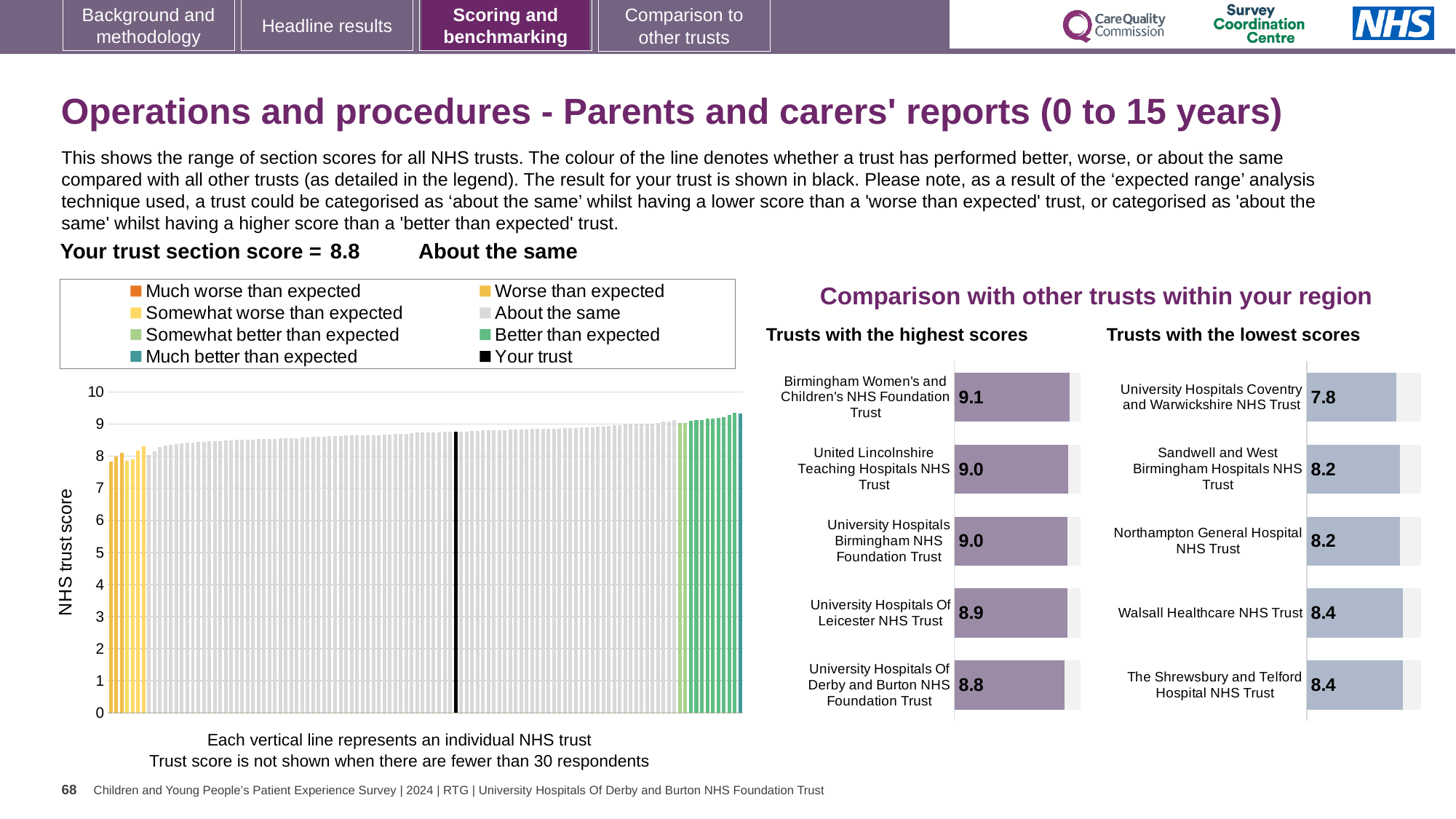
In the large chart on the left, is the value for the rightmost bar greater or less than 9? greater In the 'Trusts with the highest scores' chart, how many trusts are shown? 5 In the large chart on the left, what is the label on the vertical axis? NHS trust score In the 'Trusts with the highest scores' chart, what is the score for Birmingham Women's and Children's NHS Foundation Trust? 9.1 In the large chart on the left, is the value for the black bar (your trust) greater or less than 8? greater In the 'Trusts with the lowest scores' chart, which trust has the lowest score? University Hospitals Coventry and Warwickshire NHS Trust In the 'Trusts with the highest scores' chart, what is the difference between the scores of Birmingham Women's and Children's NHS Foundation Trust and University Hospitals Of Derby and Burton NHS Foundation Trust? 0.3 What kind of chart is the large chart on the left showing NHS trust scores? bar chart How many entries does the legend above the large chart on the left list? 8 In the large chart on the left, do the trust scores rise or fall from left to right along the x axis? rise In the 'Trusts with the lowest scores' chart, which has the larger score: Walsall Healthcare NHS Trust or University Hospitals Coventry and Warwickshire NHS Trust? Walsall Healthcare NHS Trust In the 'Trusts with the highest scores' chart, which trust has the highest score? Birmingham Women's and Children's NHS Foundation Trust